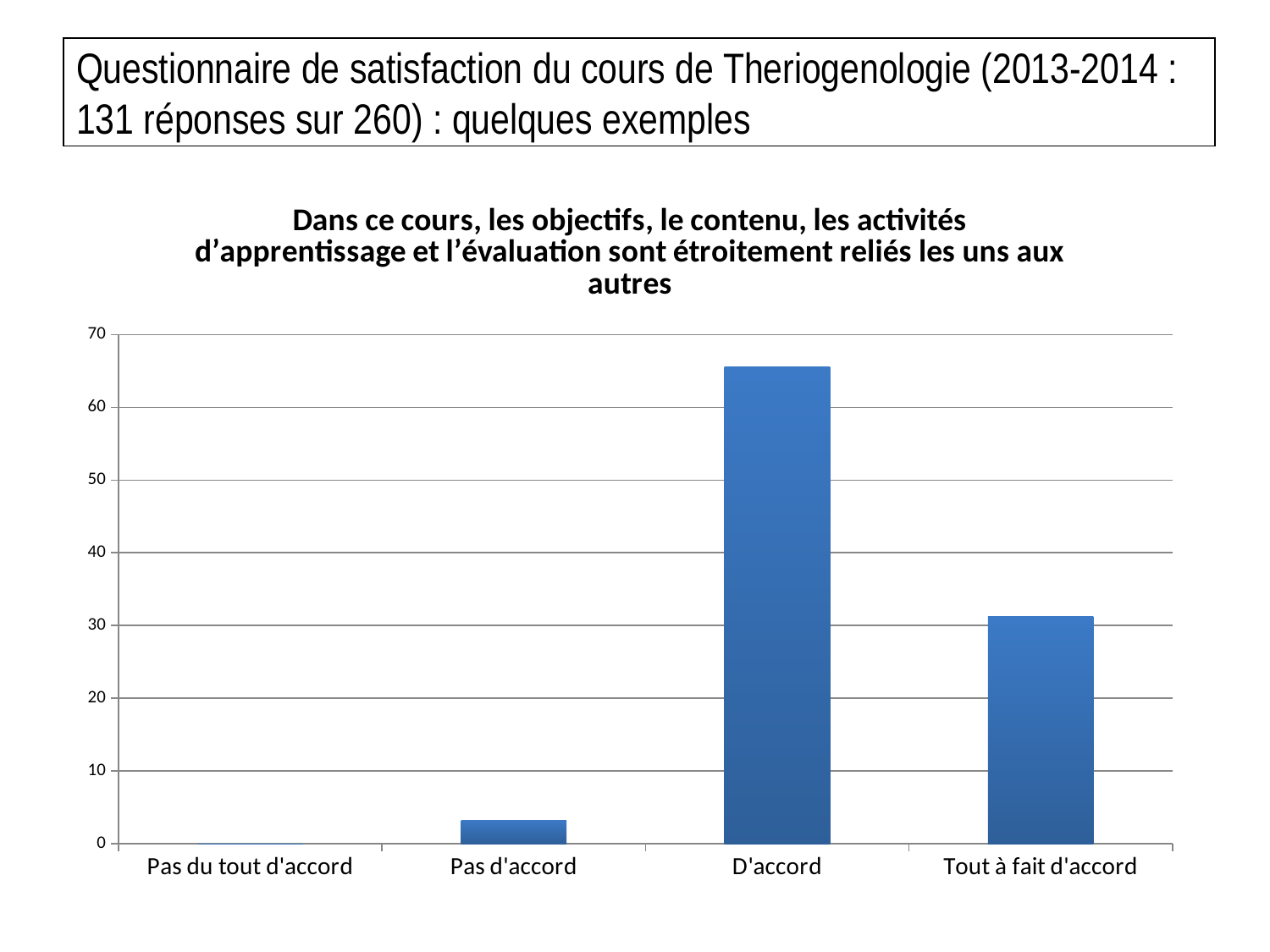
Is the value for Tout à fait d'accord greater or less than 30? greater What kind of chart is shown on the slide? bar chart Which category has the highest value in the chart? D'accord How many categories are shown on the x axis of the chart? 4 Which is larger, the value for D'accord or the value for Tout à fait d'accord? D'accord Which is larger, the value for Pas d'accord or the value for Tout à fait d'accord? Tout à fait d'accord Is the value for Tout à fait d'accord greater or less than 40? less Is the value for D'accord greater or less than 60? greater What is the label of the third category on the x axis of the chart? D'accord Which category has the lowest value in the chart? Pas du tout d'accord What is the highest value shown on the y axis of the chart? 70